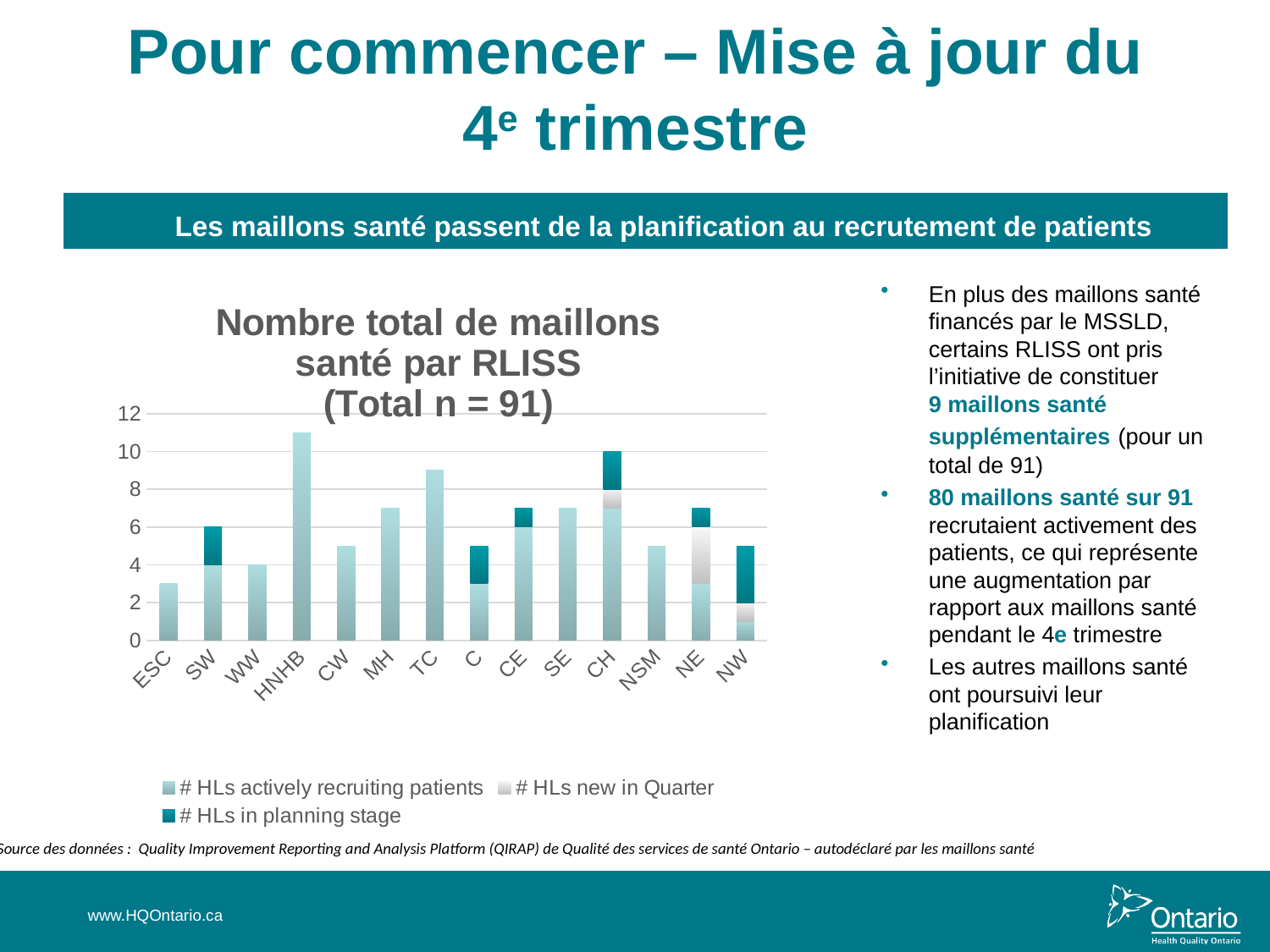
Is the total value for ESC greater or less than 4? less What is the total height of the bar for CH? 10 What kind of chart is shown on the slide? bar chart Which RLISS has the shortest bar in the chart? ESC What is the title of the chart? Nombre total de maillons santé par RLISS (Total n = 91) How many RLISS categories are shown on the x axis of the chart? 14 Which bar is taller, HNHB or TC? HNHB Is the total value for HNHB greater or less than 10? greater Which RLISS has the tallest bar in the chart? HNHB What is the total height of the bar for WW? 4 Is the total value for TC greater or less than 8? greater How many series does the chart legend list? 3